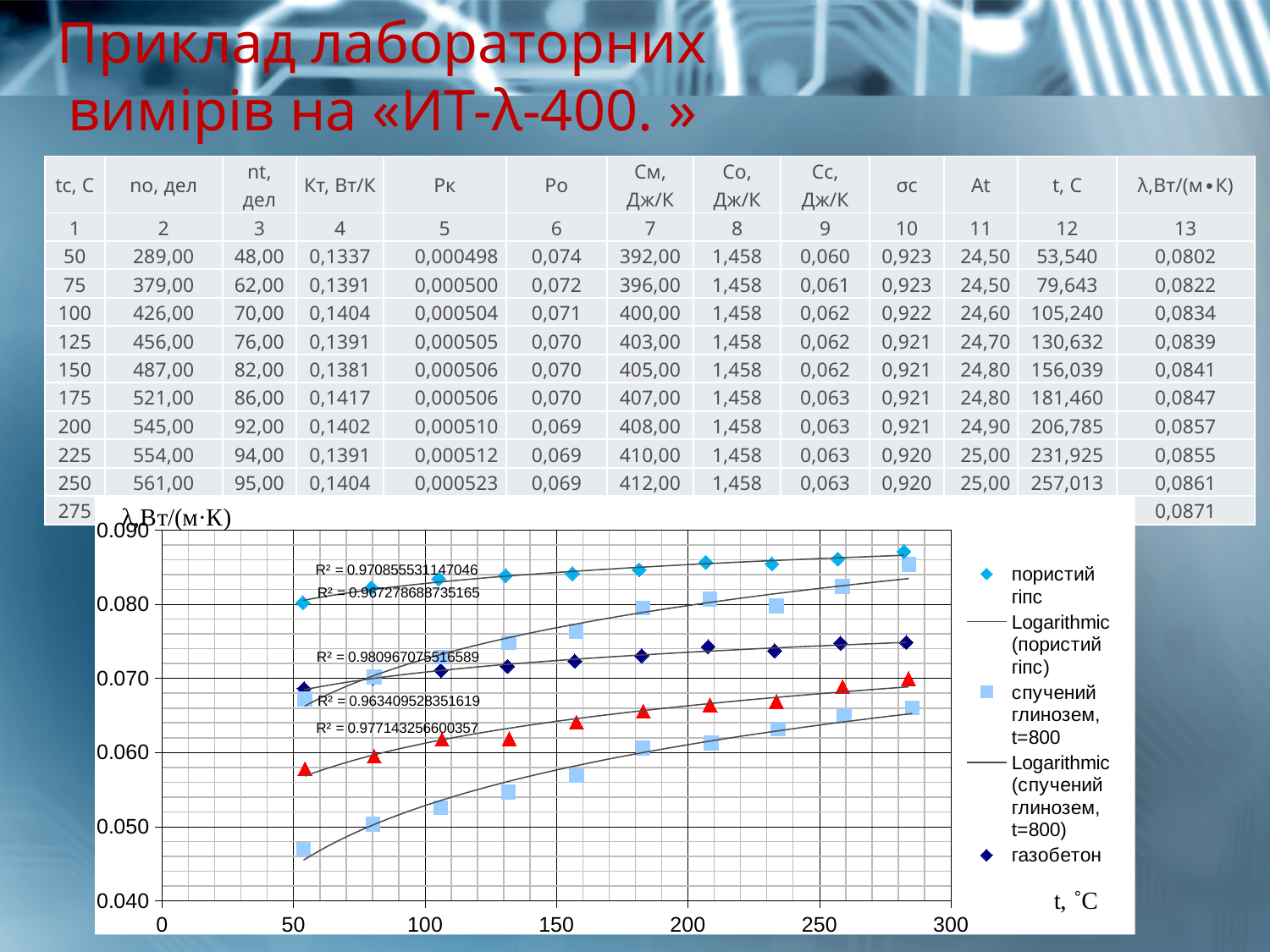
What is the smallest R² value printed on the chart? R² = 0.963409528351619 What is the label of the chart's x axis? t, °C Is the value for газобетон at about 50 °C greater or less than 0.070? less Is the value for пористий гіпс at about 280 °C greater or less than 0.080? greater How many R² values are printed on the chart? 5 What is the label of the chart's y axis? λ, Вт/(м·К) What is the largest R² value printed on the chart? R² = 0.980967075516589 Do the values for пористий гіпс rise or fall as t increases along the x axis? rise What kind of chart is shown below the table? scatter chart At about 280 °C, which is larger: the value for пористий гіпс or the value for газобетон? пористий гіпс Which series on the chart has the highest λ values across the whole temperature range? пористий гіпс Is the lowest plotted point on the chart (at about 50 °C) greater or less than 0.050? less